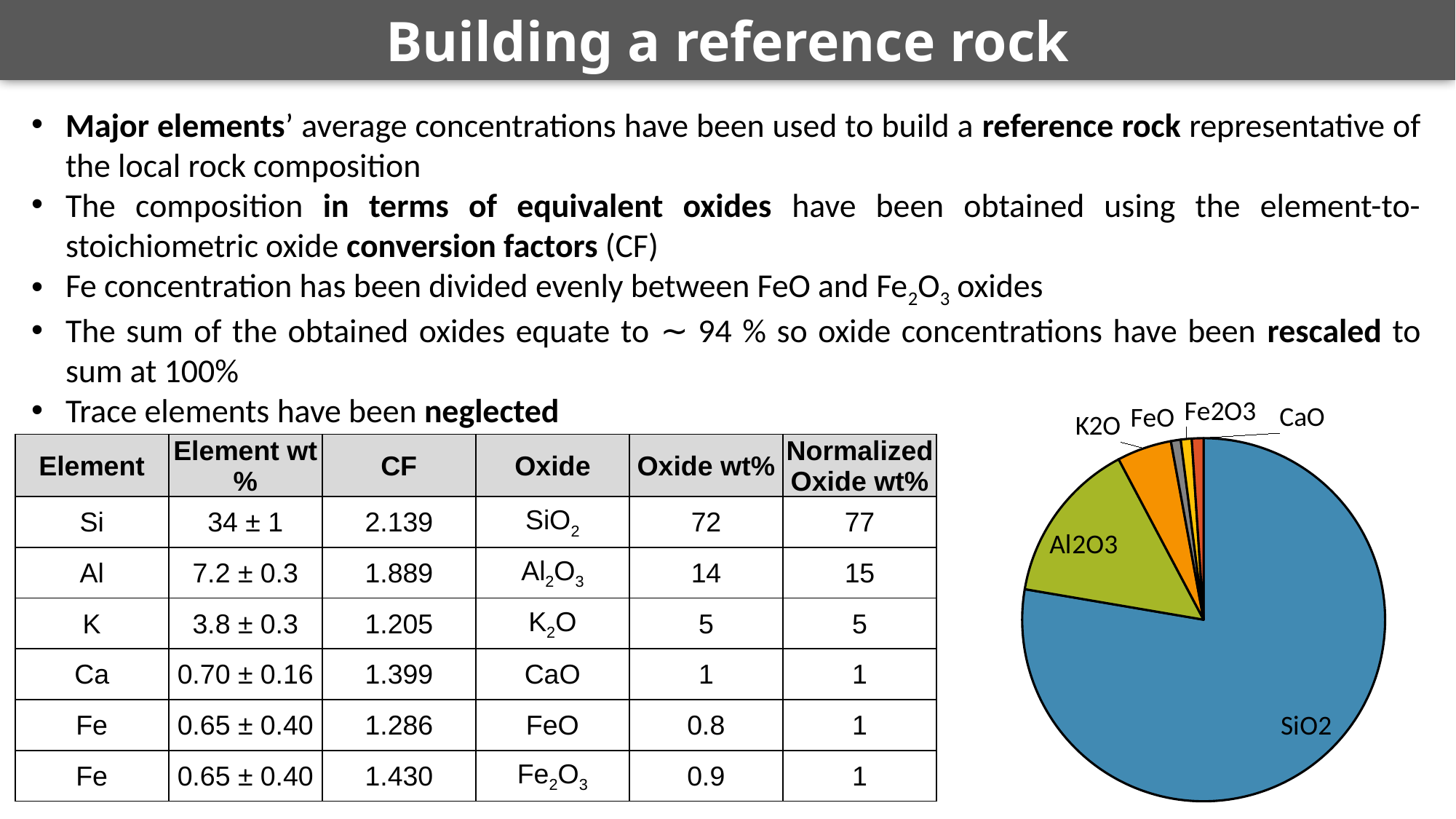
Does the SiO2 slice take up more or less than half of the pie chart? more What colour is the SiO2 slice in the pie chart? blue What kind of chart is shown on the slide? pie chart Which slice is larger in the pie chart, Al2O3 or FeO? Al2O3 Which oxide has the largest slice in the pie chart? SiO2 Which slice is larger in the pie chart, SiO2 or Al2O3? SiO2 Which oxide has the second-largest slice in the pie chart? Al2O3 Which slice is larger in the pie chart, K2O or CaO? K2O What colour is the Al2O3 slice in the pie chart? green How many slices does the pie chart have? 6